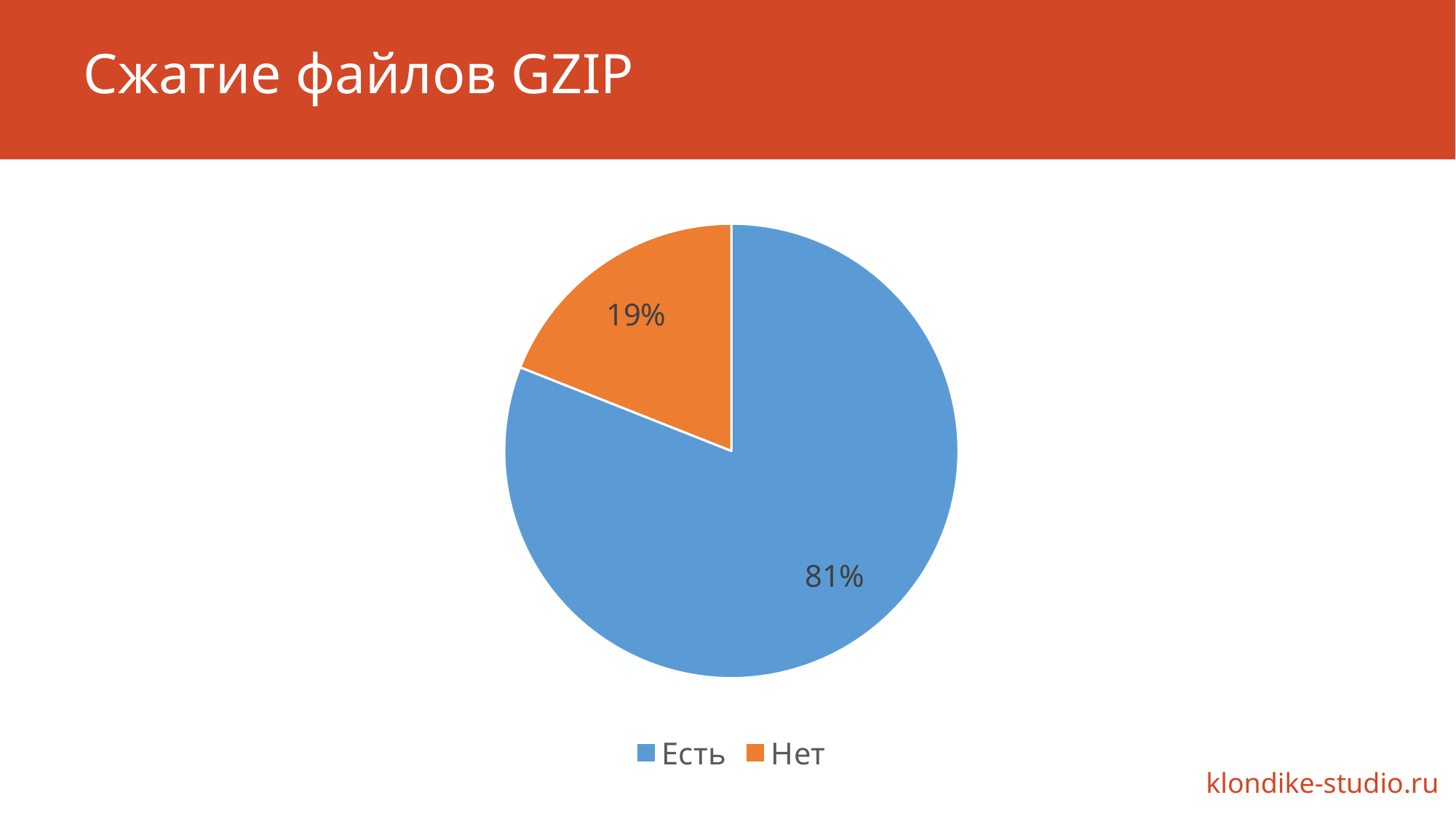
What colour is the "Нет" slice in the pie chart? orange What kind of chart is shown on the slide? pie chart Which slice is the largest in the pie chart? Есть What share of the pie does the "Есть" slice represent? 81% What share of the pie does the "Нет" slice represent? 19% What is the title of the slide containing the chart? Сжатие файлов GZIP Which is larger, the "Есть" slice or the "Нет" slice? Есть How many entries does the legend list? 2 What is the difference in percentage points between the "Есть" and "Нет" slices? 62 How many slices does the pie chart have? 2 Which slice is the smallest in the pie chart? Нет